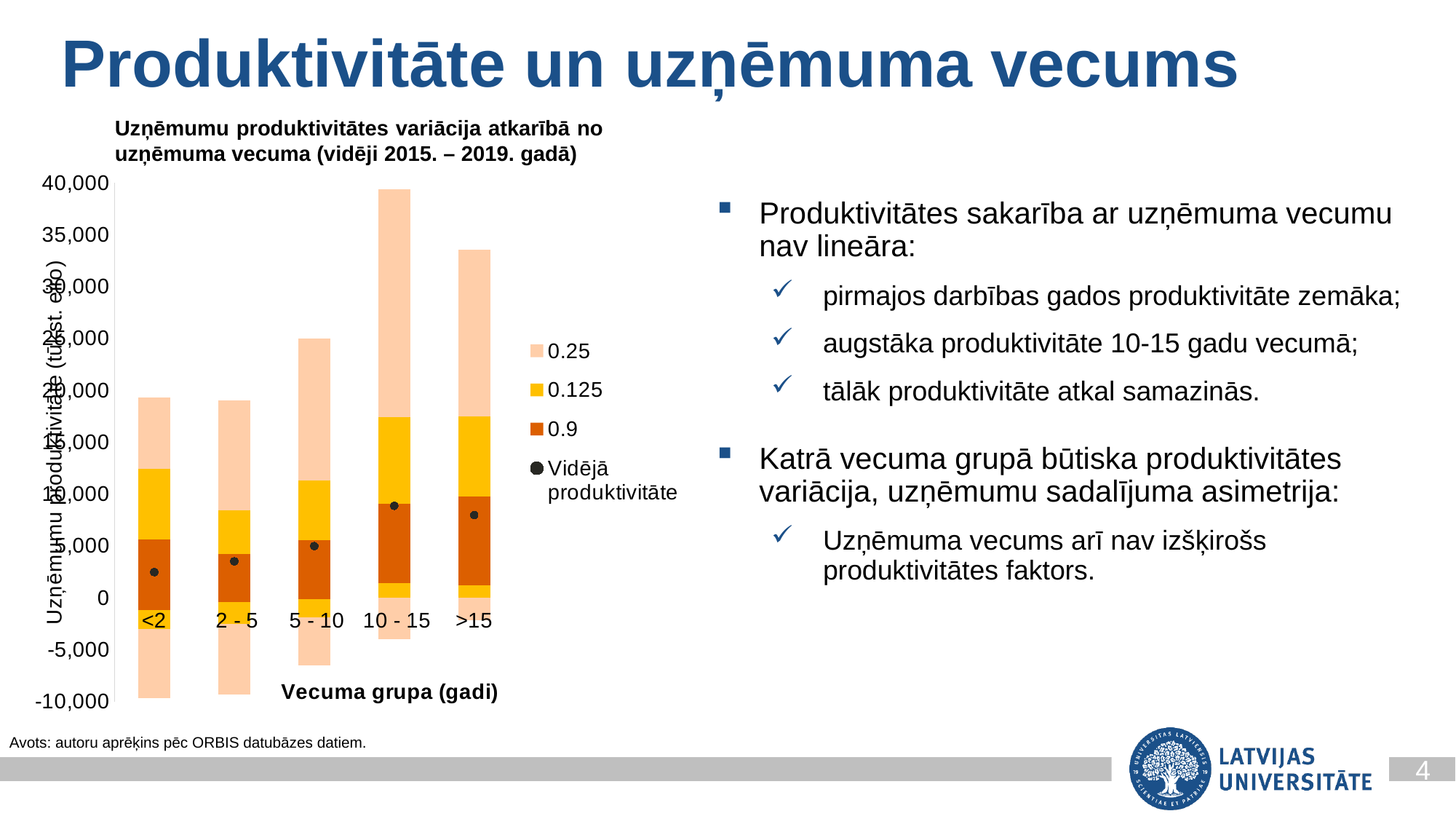
Which age group has a higher average productivity dot, 10 - 15 or >15? 10 - 15 Is the top of the bar for the 10 - 15 age group greater or less than 35,000? greater Which age group has the highest average productivity (Vidējā produktivitāte) dot? 10 - 15 Which age group has the lowest average productivity (Vidējā produktivitāte) dot? <2 What is the label of the x axis of the chart? Vecuma grupa (gadi) Which legend entry is represented by the black dots in the chart? Vidējā produktivitāte How many entries does the chart legend list? 4 How many age groups are shown on the x axis of the chart? 5 Is the top of the bar for the >15 age group greater or less than 35,000? less Which age group has the bar reaching the highest value on the chart? 10 - 15 What kind of chart is shown on the slide? Stacked bar chart with a dot series Is the average productivity dot for the <2 age group greater or less than 5,000? less